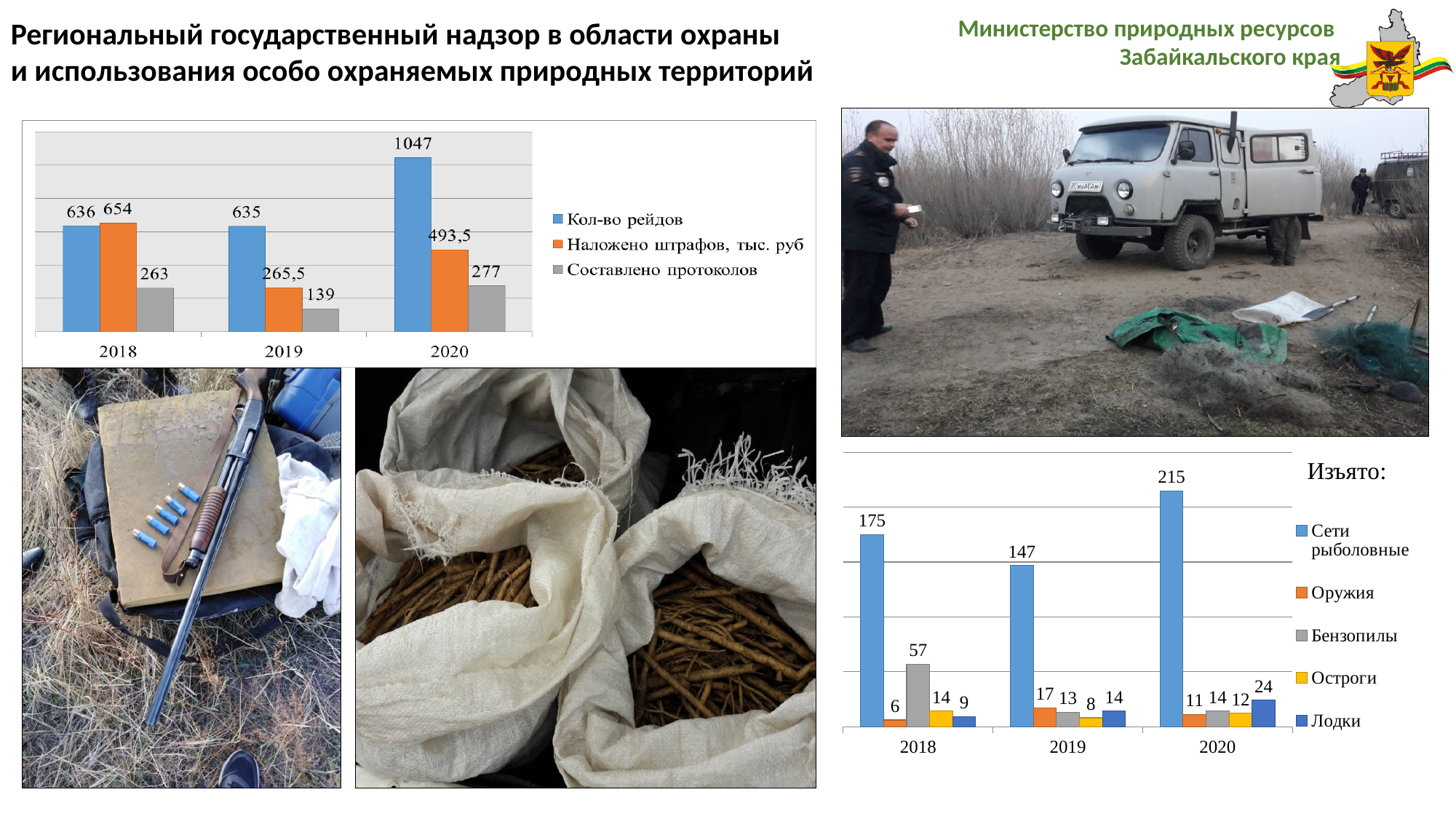
In the top-left chart, how many series does the legend list? 3 In the top-left chart, does Кол-во рейдов rise or fall from 2019 to 2020? rise In the top-left chart, what is the difference between Кол-во рейдов in 2020 and in 2019? 412 In the chart titled Изъято:, in which year is Сети рыболовные highest? 2020 In the chart titled Изъято:, which is larger in 2018: Бензопилы or Остроги? Бензопилы In the chart titled Изъято:, what is the value of Лодки for 2020? 24 In the chart titled Изъято:, how many series does the legend list? 5 In the top-left chart, what is the value of Кол-во рейдов for 2020? 1047 In the top-left chart, in which year is Составлено протоколов lowest? 2019 In the top-left chart, what is the value of Наложено штрафов, тыс. руб for 2019? 265,5 What kind of chart is the chart titled Изъято:? bar chart In the chart titled Изъято:, what is the value of Сети рыболовные for 2018? 175